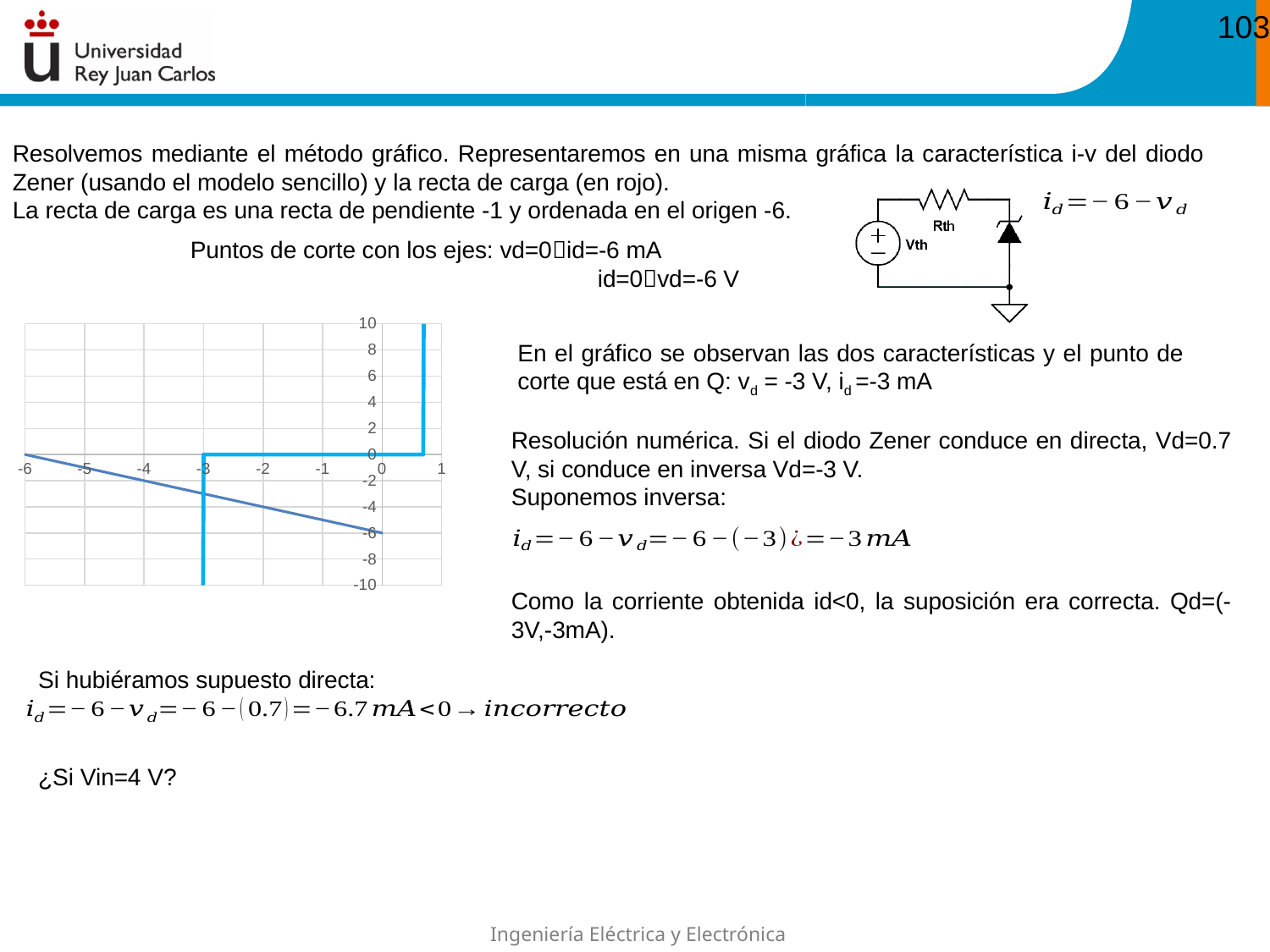
At what x value does the light-blue diode characteristic have its vertical segment on the negative side of the axis? -3 Is the value of the blue load line at x = -3 greater or less than -6? greater At what y value does the blue load line cross the vertical axis (x = 0)? -6 How many lines are plotted on the chart? 2 At what x value does the blue load line cross the horizontal axis? -6 What kind of chart is shown on the slide? line chart What is the highest value shown on the vertical axis of the chart? 10 Is the value of the blue load line at x = -3 greater or less than 0? less Is the value of the blue load line at x = 1 greater or less than -6? less What is the lowest value shown on the horizontal axis of the chart? -6 Does the blue load line rise or fall as the x value increases? fall